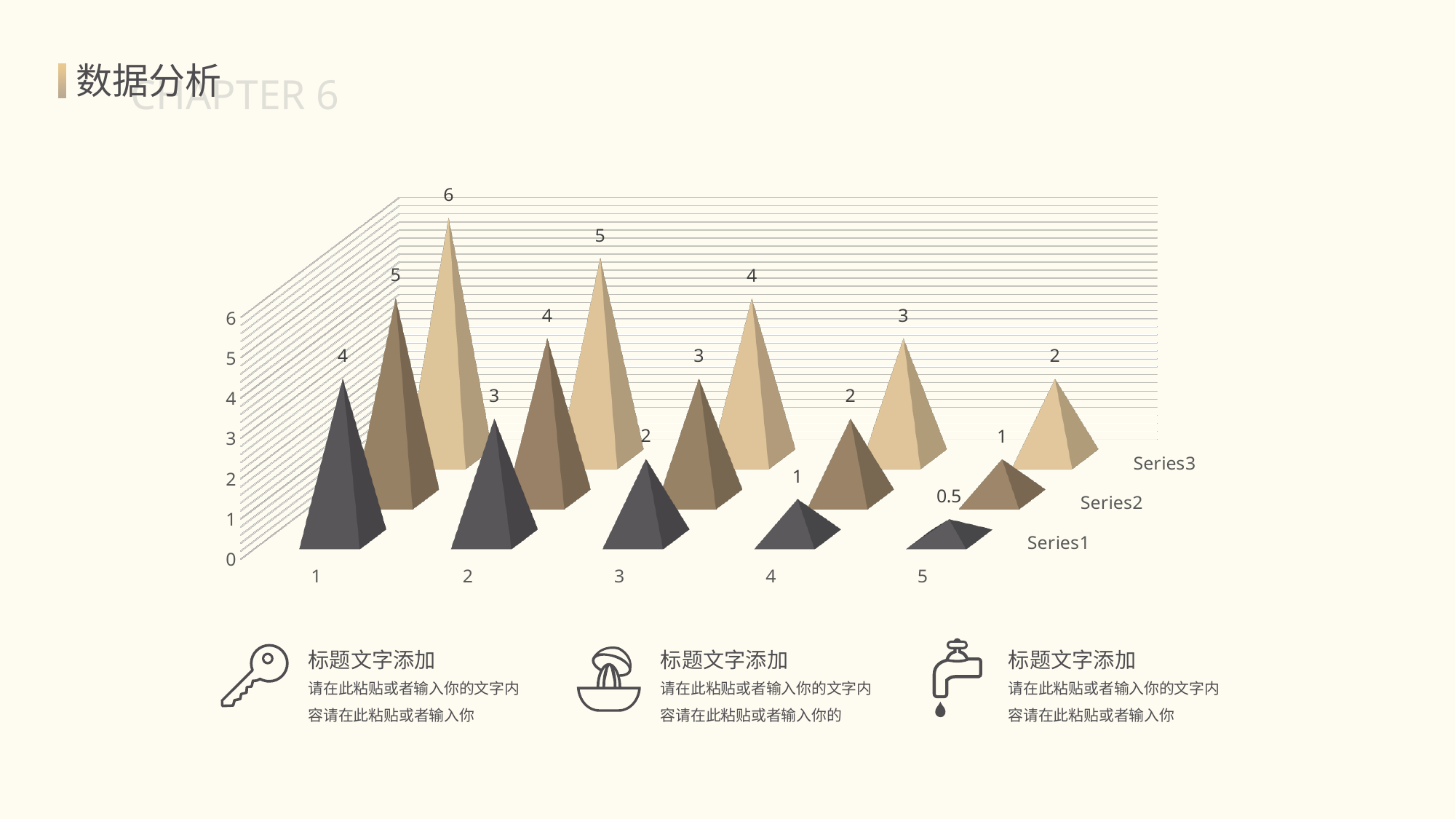
What is the value for Series2 at category 3? 3 What kind of chart is shown on the slide? bar chart What is the value for Series1 at category 1? 4 Which category has the lowest value for Series1? 5 What is the difference between the Series3 and Series1 values at category 2? 2 Which category has the highest value for Series3? 1 Do the values for Series2 rise or fall from category 1 to category 5? fall Which is larger at category 4: the value for Series2 or the value for Series3? Series3 What is the value for Series3 at category 1? 6 How many categories are shown on the x axis? 5 How many series does the chart show? 3 What is the value for Series1 at category 5? 0.5